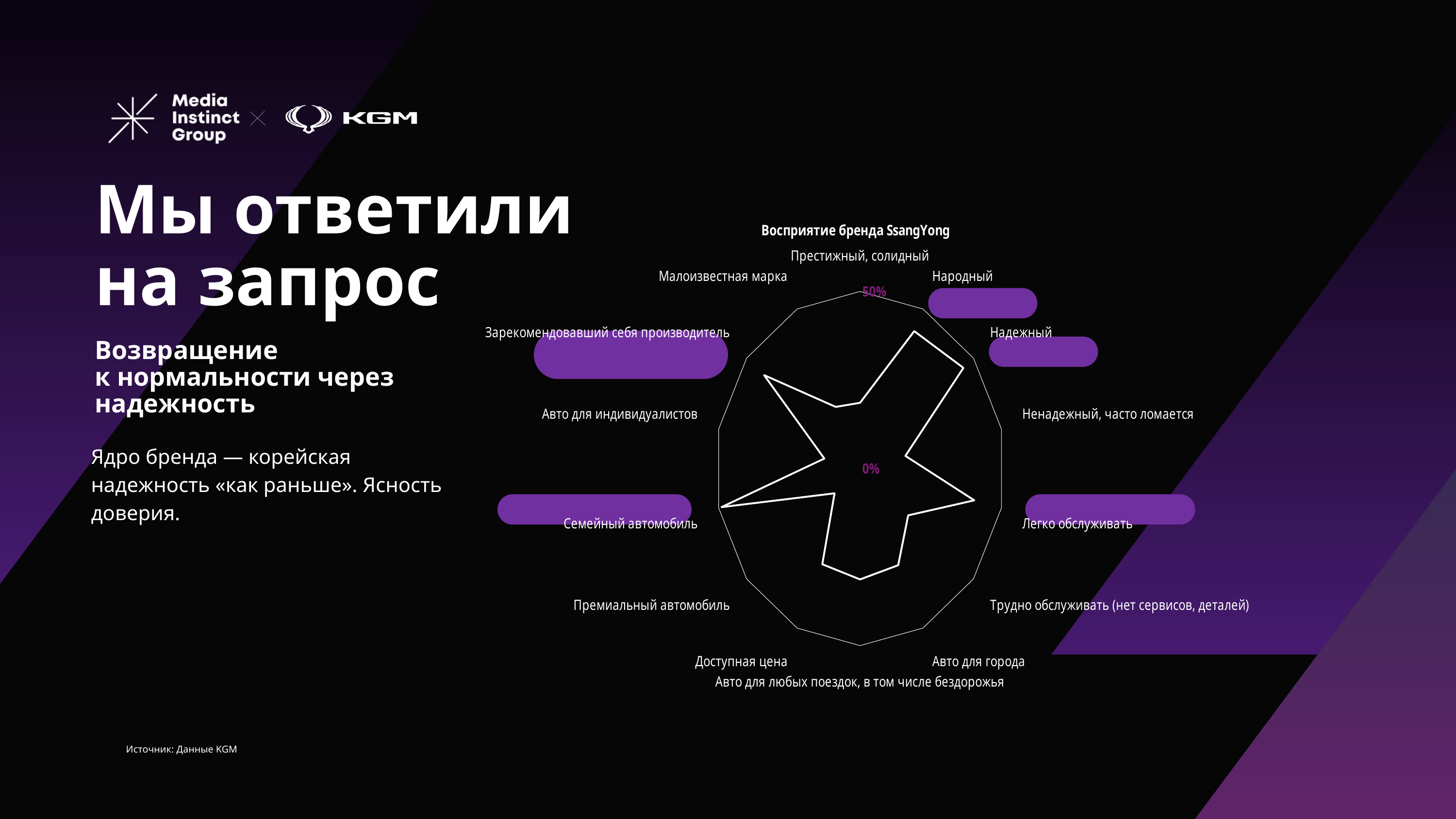
Is the value for «Ненадежный, часто ломается» greater or less than 50%? less What is the title of the chart? Восприятие бренда SsangYong Which is larger: the value for «Народный» or for «Ненадежный, часто ломается»? Народный Is the value for «Премиальный автомобиль» greater or less than 50%? less Which is larger: the value for «Зарекомендовавший себя производитель» or for «Малоизвестная марка»? Зарекомендовавший себя производитель Which is larger: the value for «Семейный автомобиль» or for «Премиальный автомобиль»? Семейный автомобиль Is the value for «Малоизвестная марка» greater or less than 50%? less What is the value printed at the outer ring of the radar chart? 50% What kind of chart is shown on the slide? Radar chart How many categories (axes) does the radar chart have? 14